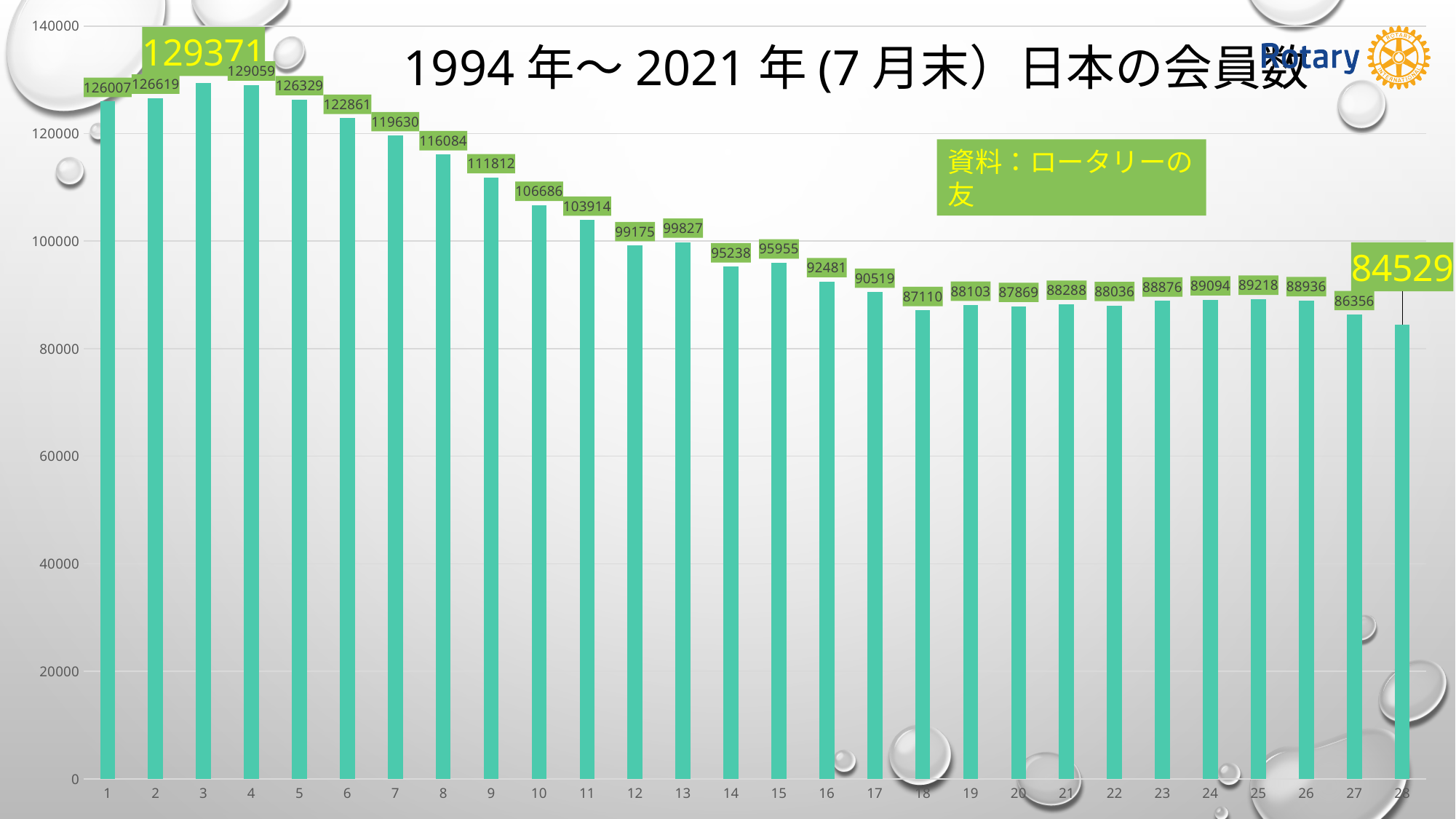
Which category has the lowest value? 28 What kind of chart is shown on the slide? Bar chart What is the difference between the values for category 3 and category 28? 44842 What is the value for category 10? 106686 What is the value for category 3? 129371 How many categories are shown on the x axis? 28 Which category has the highest value? 3 What is the value for category 18? 87110 Is the value for category 9 greater or less than 100000? greater Do the values generally rise or fall from category 1 to category 28? Fall What is the value for category 28? 84529 Which is larger, the value for category 12 or category 13? Category 13